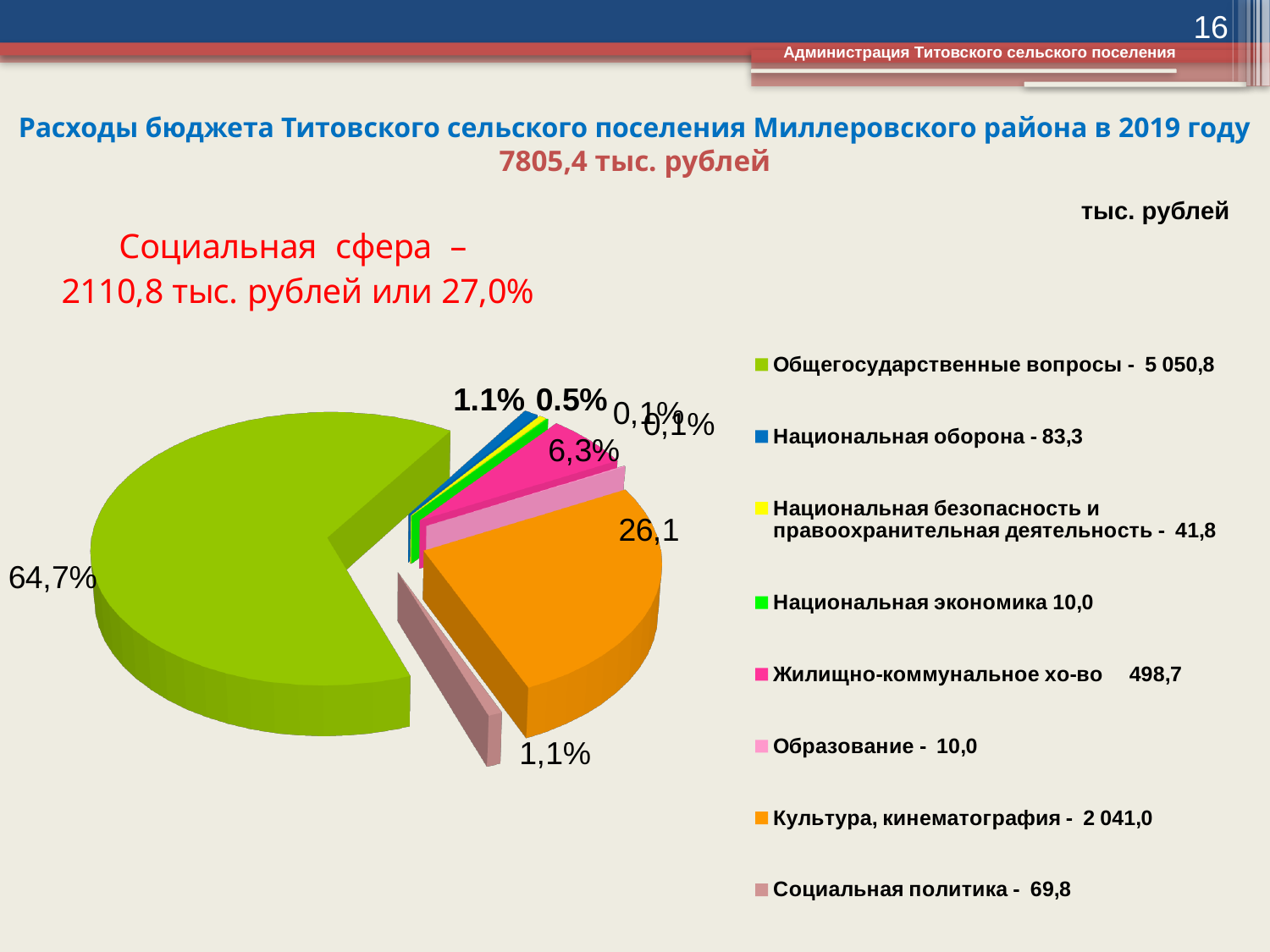
What is the difference between Общегосударственные вопросы (5 050,8) and Культура, кинематография (2 041,0)? 3 009,8 What unit is stated above the legend for the values? тыс. рублей Which category has the largest share of the pie? Общегосударственные вопросы What is the value for Национальная оборона in the legend? 83,3 Which is larger: Национальная оборона or Социальная политика? Национальная оборона What kind of chart is shown on the slide? pie chart What is the value for Культура, кинематография in the legend? 2 041,0 What is the difference between Национальная оборона (83,3) and Социальная политика (69,8)? 13,5 What is the value for Жилищно-коммунальное хо-во in the legend? 498,7 What percentage share of the pie is labelled for the largest slice? 64,7% What is the value for Общегосударственные вопросы in the legend? 5 050,8 How many categories does the legend of the pie chart list? 8